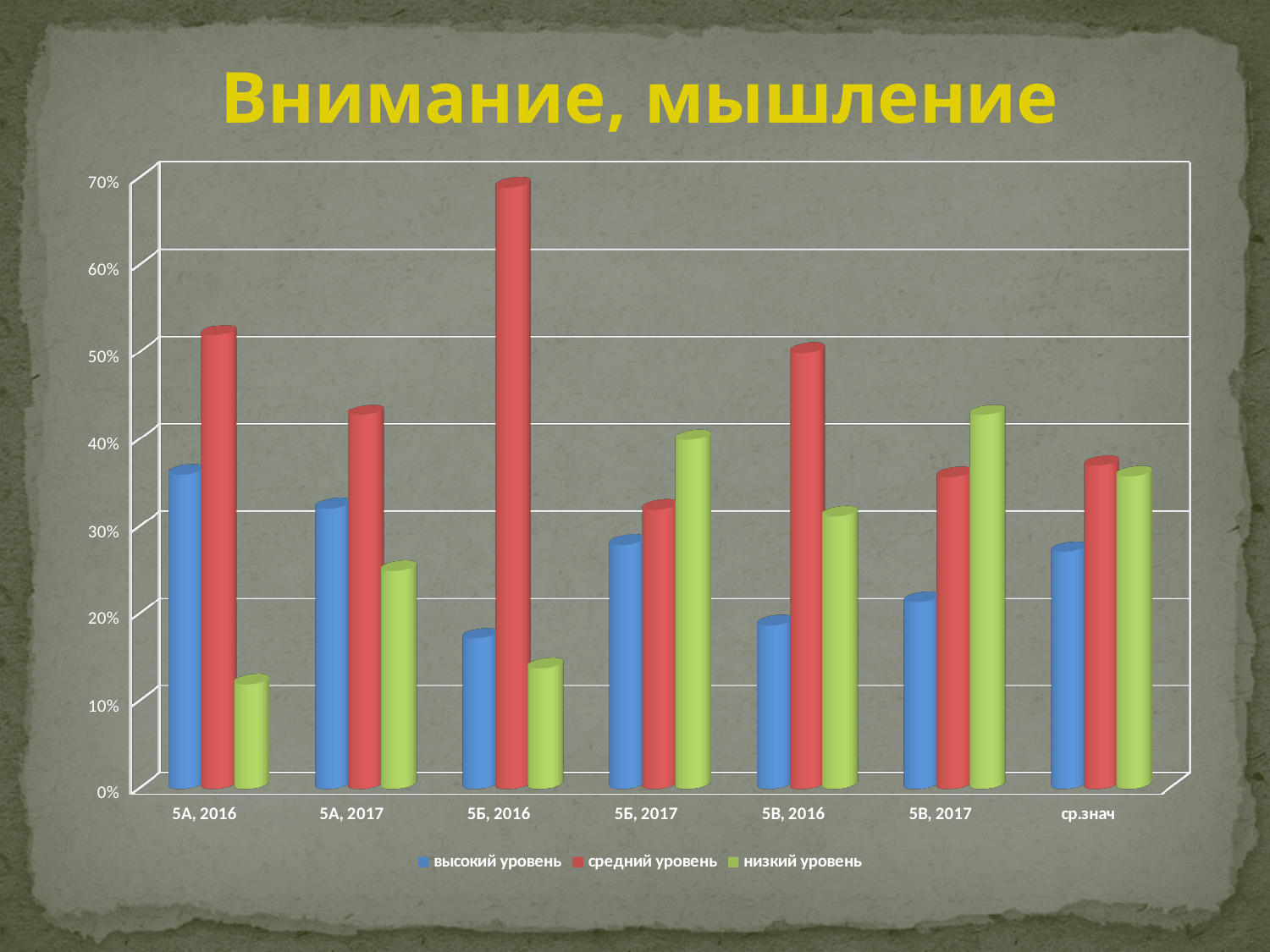
Is the value for средний уровень in 5Б, 2016 greater or less than 60%? greater Is the value for низкий уровень in 5А, 2016 greater or less than 20%? less How many series does the chart's legend list? 3 What kind of chart is shown on the slide? bar chart In 5В, 2017, which is larger: средний уровень or низкий уровень? низкий уровень Which category has the lowest value for средний уровень? 5Б, 2017 What is the title of the chart on the slide? Внимание, мышление Which category has the highest value for высокий уровень? 5А, 2016 Which category has the highest value for средний уровень? 5Б, 2016 In 5Б, 2017, which is larger: высокий уровень or низкий уровень? низкий уровень How many categories are shown along the x axis of the chart? 7 Is the value for высокий уровень in 5Б, 2016 greater or less than 20%? less